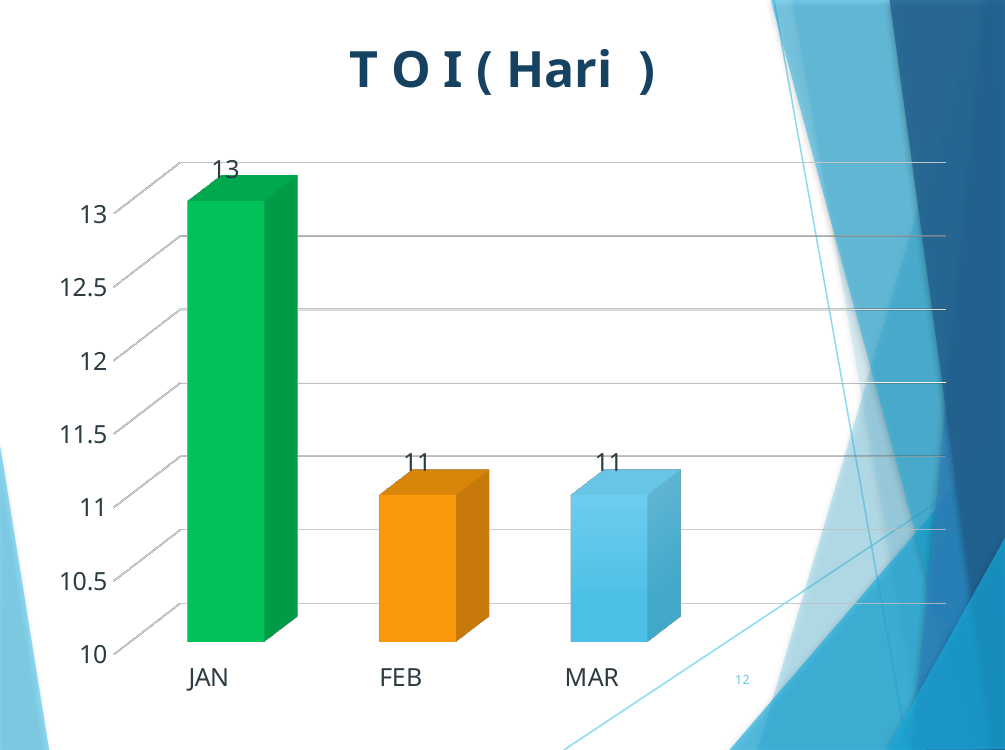
What is the title of the chart? T O I ( Hari ) What is the value for MAR? 11 Which is larger, the value for JAN or the value for MAR? JAN What is the value for FEB? 11 What colour is the bar for JAN? green What is the difference between the values for JAN and FEB? 2 How many months are shown on the chart? 3 Which month has the highest value? JAN What is the value for JAN? 13 What kind of chart is shown on the slide? bar chart Is the value for FEB greater or less than 12? less Do the values rise or fall from JAN to FEB? fall